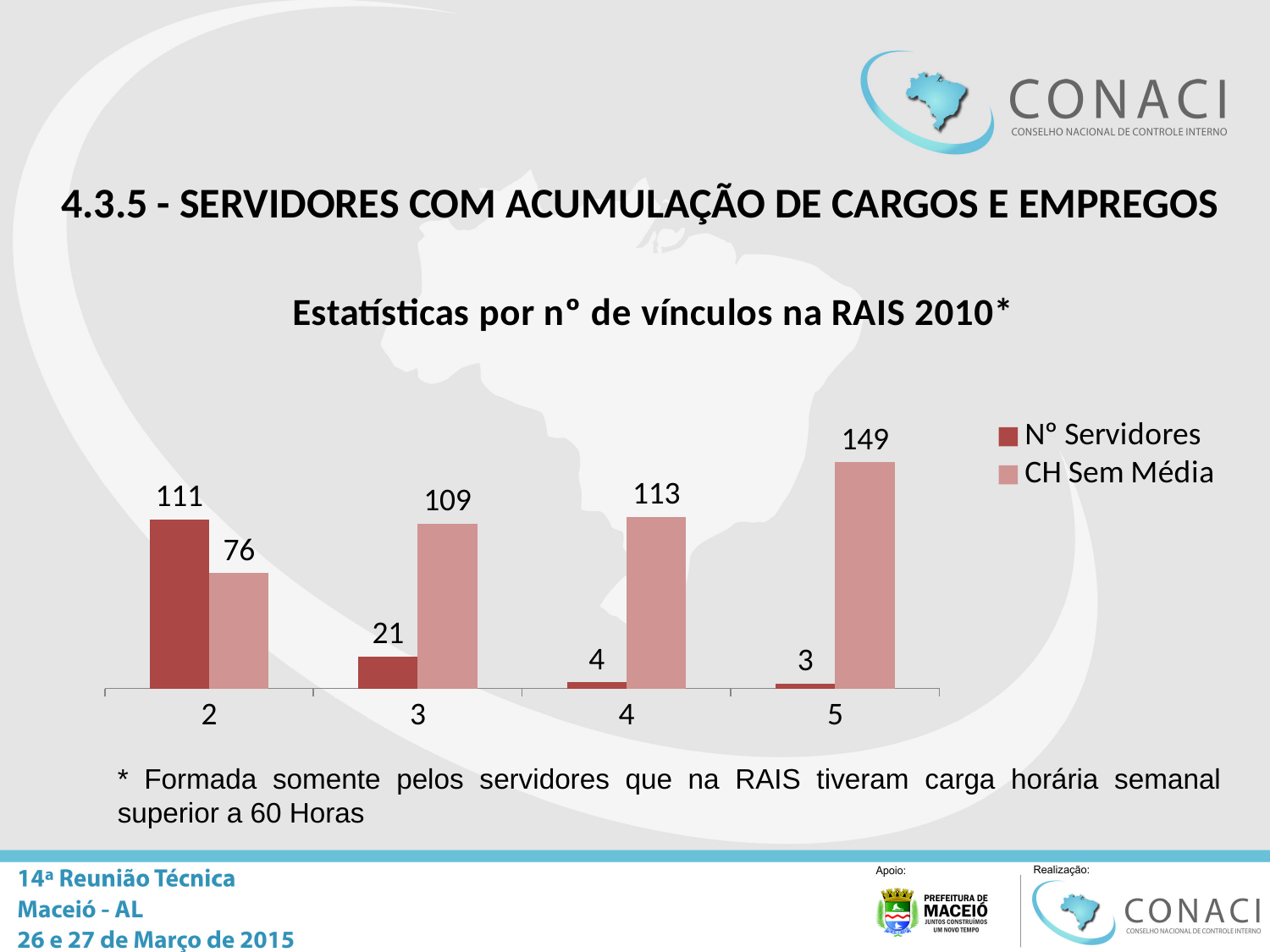
Which category has the highest value for CH Sem Média? 5 What is the difference between CH Sem Média and Nº Servidores for category 2? 35 What is the value of Nº Servidores for category 2? 111 Does the Nº Servidores series rise or fall from category 2 to category 5? Fall Which category has the lowest value for Nº Servidores? 5 Which is larger for category 3: Nº Servidores or CH Sem Média? CH Sem Média How many categories are shown on the x axis? 4 What is the value of CH Sem Média for category 5? 149 What kind of chart is shown on the slide? Bar chart How many series does the legend list? 2 What is the value of CH Sem Média for category 4? 113 What is the value of Nº Servidores for category 3? 21